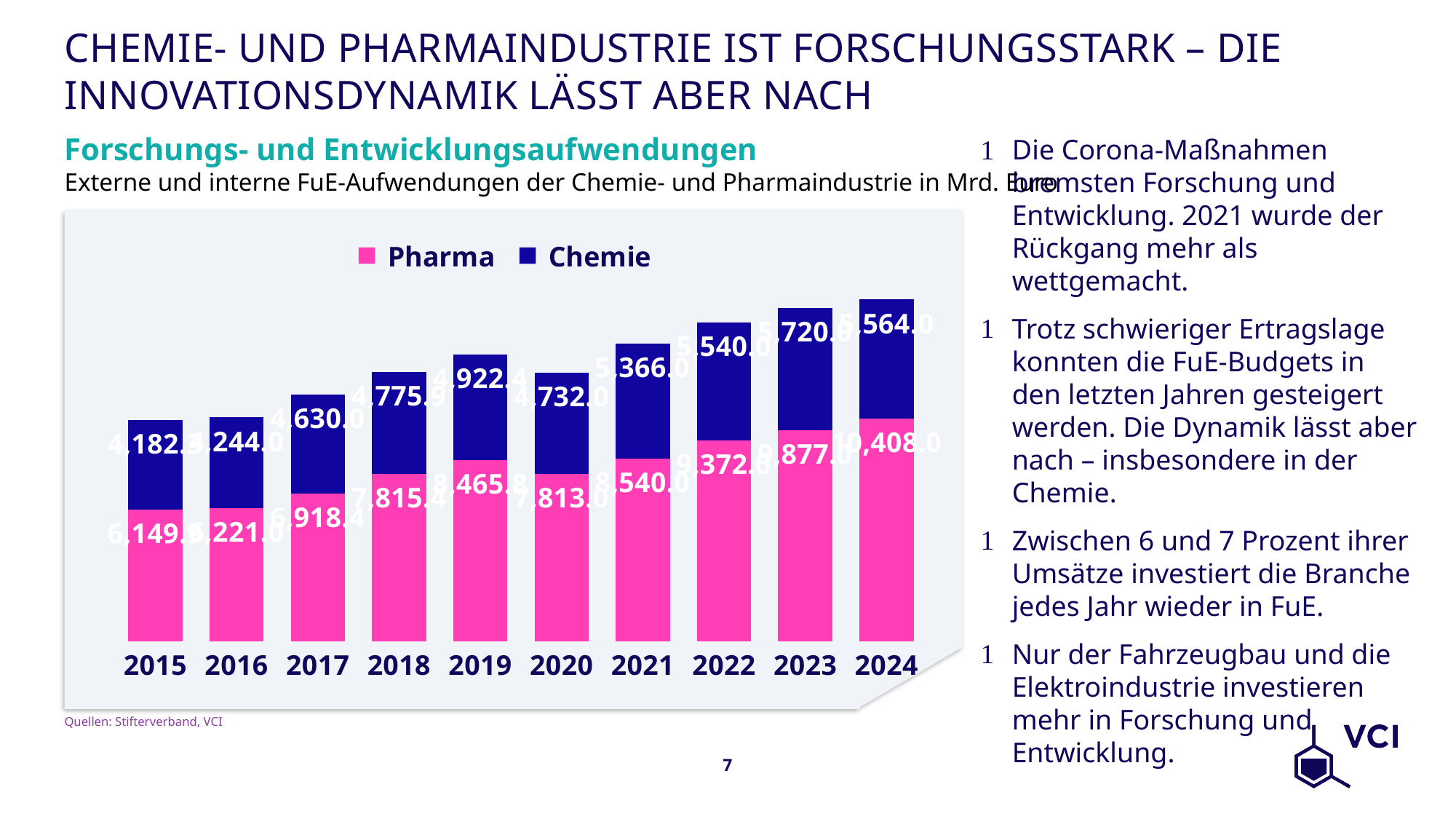
What is the Pharma value for 2019? 8,465.8 What is the difference between the Chemie values for 2023 and 2024? 156.0 What kind of chart is shown on the slide? Stacked bar chart How many series does the legend list? 2 What is the Chemie value for 2021? 5,366.0 Which is larger, the Pharma value for 2019 or for 2020? 2019 How many years are shown on the x axis? 10 What is the Pharma value for 2024? 10,408.0 In which year is the Chemie value highest? 2023 Which colour represents Pharma in the legend? Pink In which year is the Pharma value highest? 2024 What is the total of the stacked bar for 2024? 15,972.0